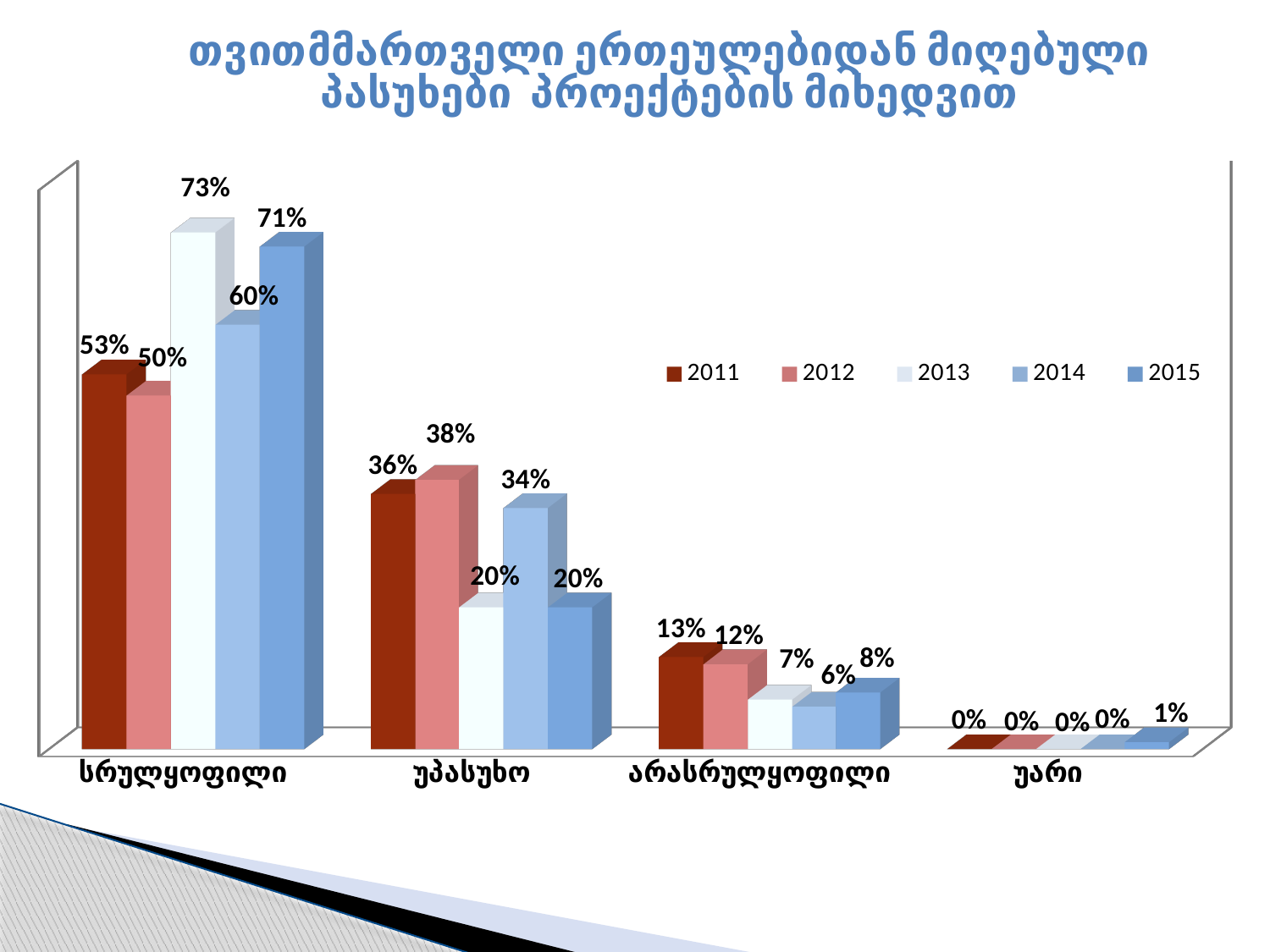
What is the value for 2015 in the უარი category? 1% What is the difference between the 2013 and 2011 values in the სრულყოფილი category? 20% How many series does the legend list? 5 What is the value for 2011 in the არასრულყოფილი category? 13% Which year has the lowest value in the არასრულყოფილი category? 2014 What kind of chart is shown on the slide? Bar chart Which years are listed in the legend? 2011, 2012, 2013, 2014, 2015 How many categories are shown on the x axis? 4 What is the value for 2013 in the სრულყოფილი category? 73% Which is larger in the უპასუხო category: the value for 2011 or the value for 2012? 2012 Which year has the highest value in the სრულყოფილი category? 2013 What is the value for 2014 in the უპასუხო category? 34%